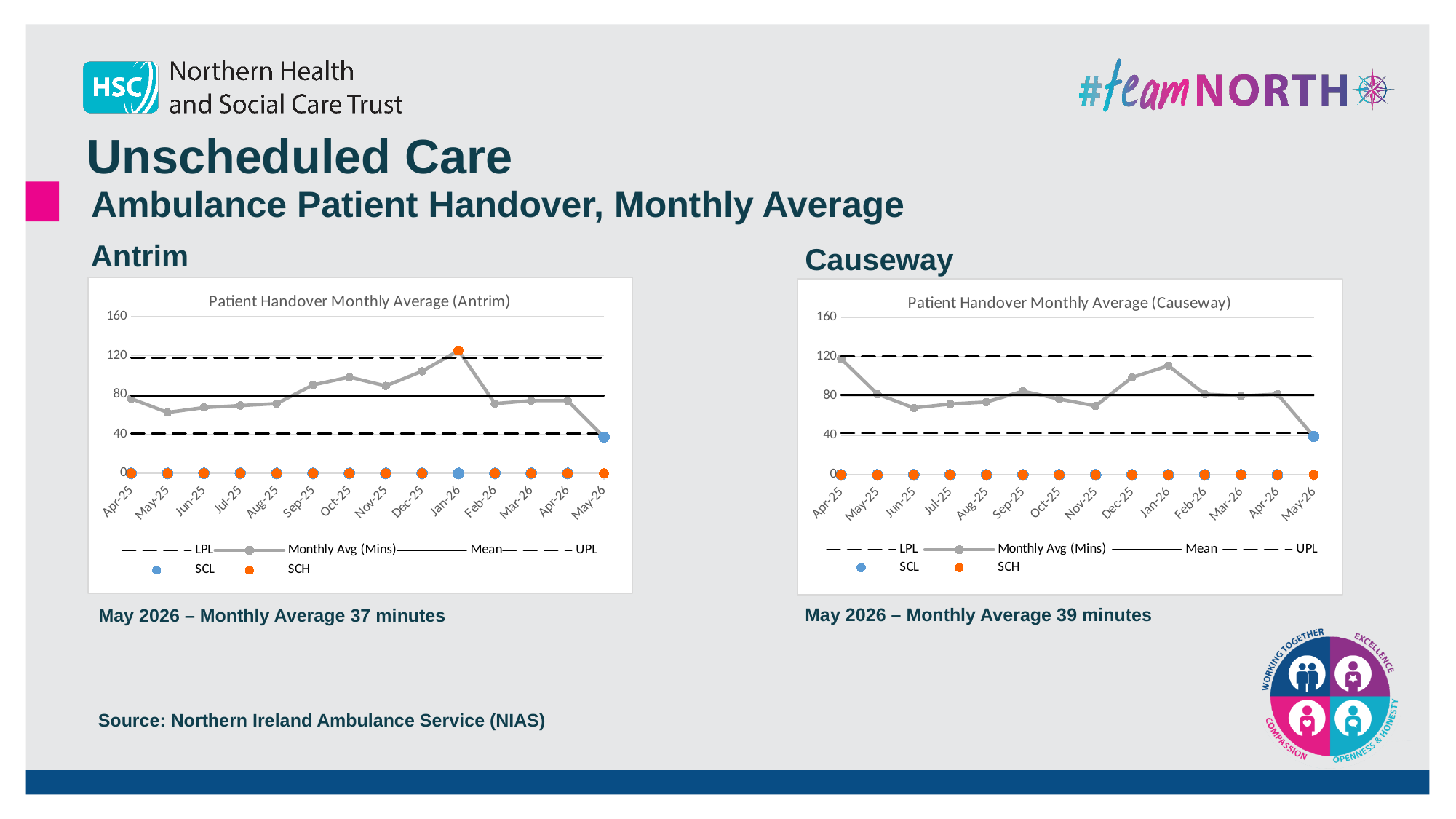
On the Antrim chart, is the monthly average for Oct-25 greater or less than 80? greater Which site had the higher monthly average in May 2026, Antrim or Causeway? Causeway How many months are plotted on the Antrim chart? 14 On the Causeway chart, what was the monthly average for May-26? 39 minutes On the Causeway chart, which is larger, the monthly average for Nov-25 or Dec-25? Dec-25 On the Antrim chart, what was the monthly average for May-26? 37 minutes What is the difference between the Causeway and Antrim monthly averages for May 2026? 2 minutes How many series does the legend of the Causeway chart list? 6 On the Causeway chart, which month has the lowest monthly average? May-26 On the Antrim chart, which month has the lowest monthly average? May-26 On the Antrim chart, which month has the highest monthly average? Jan-26 On the Causeway chart, is the monthly average for Jun-25 greater or less than 80? less